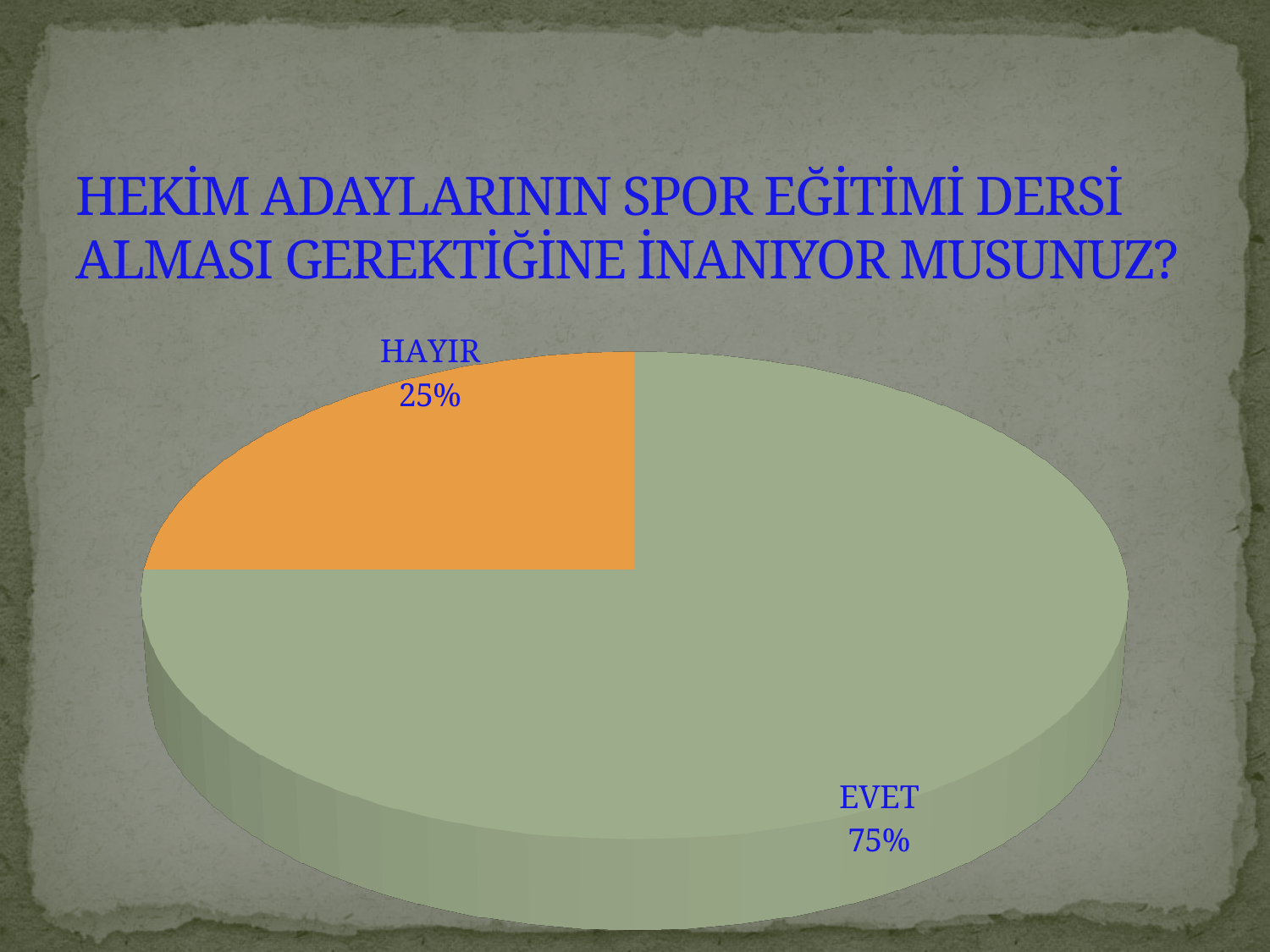
What share of the pie does HAYIR represent? 25% What kind of chart is shown on the slide? Pie chart Which slice of the pie is the smallest? HAYIR How many slices does the pie chart have? 2 What is the title of the slide above the chart? HEKİM ADAYLARININ SPOR EĞİTİMİ DERSİ ALMASI GEREKTİĞİNE İNANIYOR MUSUNUZ? Which slice of the pie is the largest? EVET What is the difference in percentage points between the EVET and HAYIR slices? 50 percentage points What share of the pie does EVET represent? 75% What colour is the HAYIR slice? Orange Which is larger, the EVET slice or the HAYIR slice? EVET